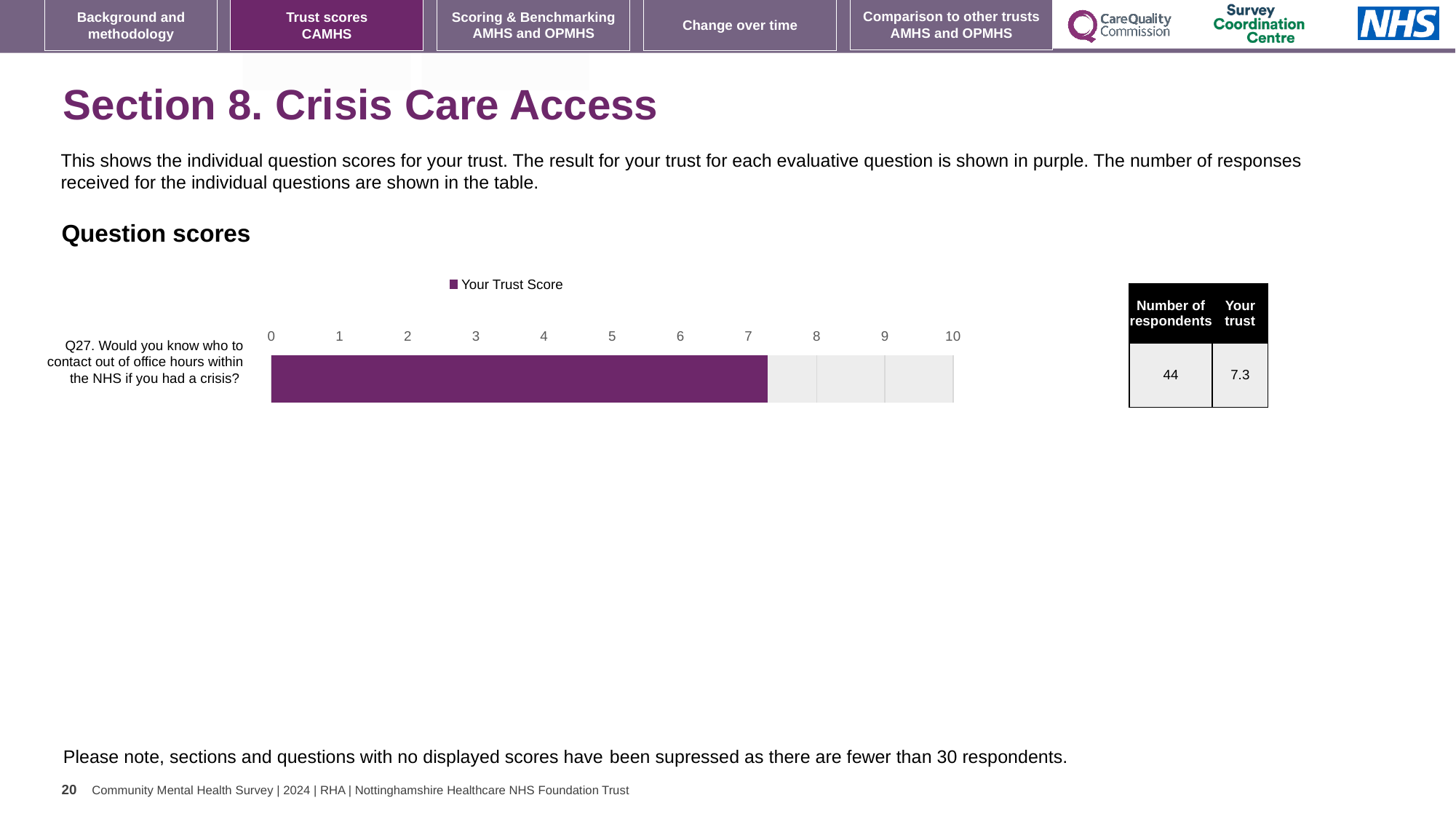
Is the bar for Q27 in the Question scores chart greater or less than 5? greater What kind of chart is shown under 'Question scores'? bar chart What is the name of the series shown in the legend of the Question scores chart? Your Trust Score What is the maximum value shown on the x axis of the Question scores chart? 10 How many questions (categories) are plotted in the Question scores chart? 1 What is the trust score for Q27 (Would you know who to contact out of office hours within the NHS if you had a crisis?) shown on the slide? 7.3 How many series does the legend of the Question scores chart list? 1 Is the bar for Q27 in the Question scores chart greater or less than 8? less How many respondents answered Q27 according to the table next to the chart? 44 Is the bar for Q27 in the Question scores chart greater or less than 7? greater